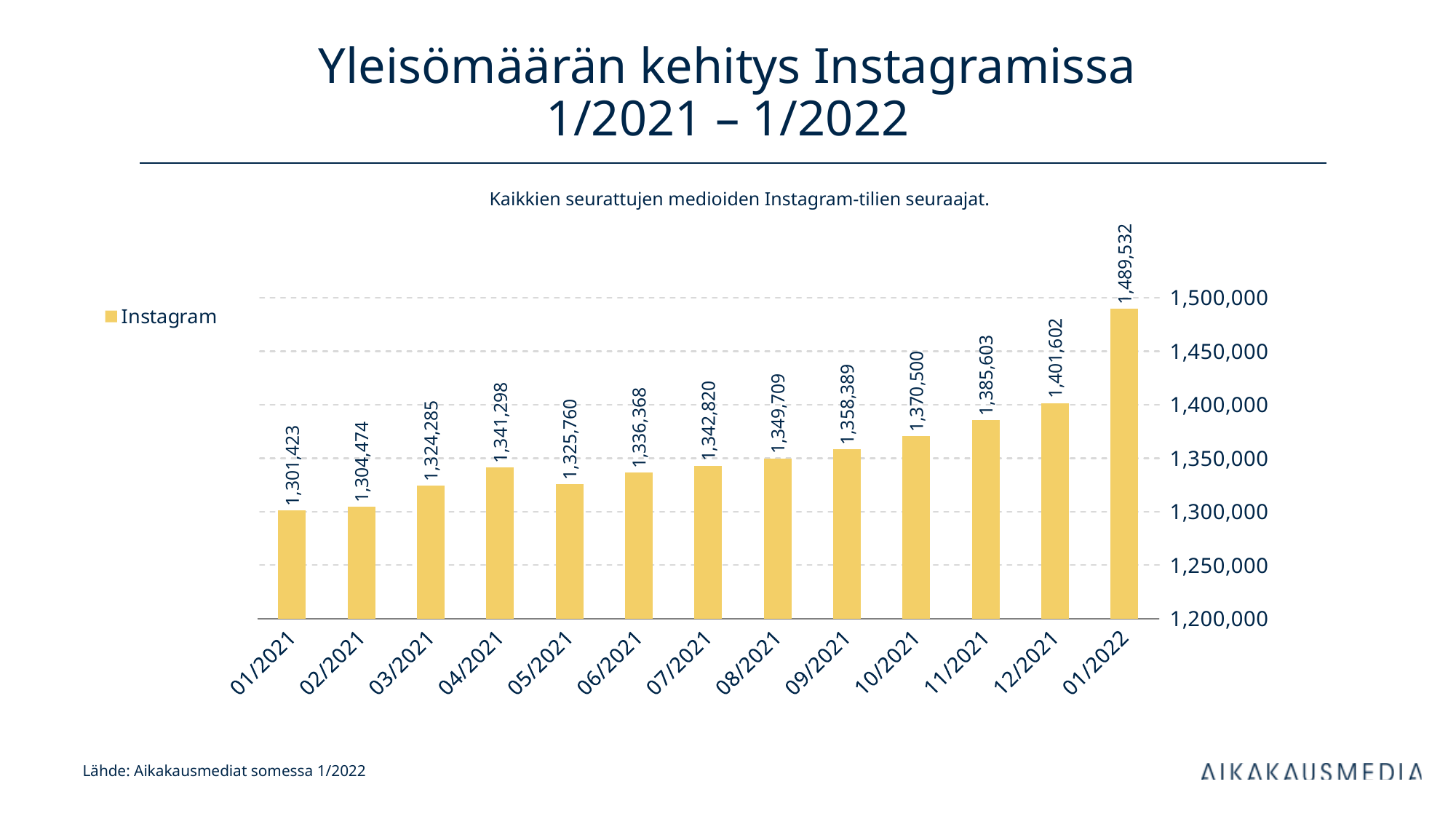
What is the value for 01/2021? 1,301,423 What kind of chart is shown on the slide? bar chart Is the value for 10/2021 greater or less than 1,350,000? greater How many series does the legend list? 1 What is the value for 12/2021? 1,401,602 Which month has the lowest value? 01/2021 What is the value for 07/2021? 1,342,820 What is the difference between the values for 01/2022 and 12/2021? 87,930 Which is larger, the value for 04/2021 or the value for 05/2021? 04/2021 Which month has the highest value? 01/2022 What is the name of the series in the legend? Instagram How many months are shown on the x axis? 13